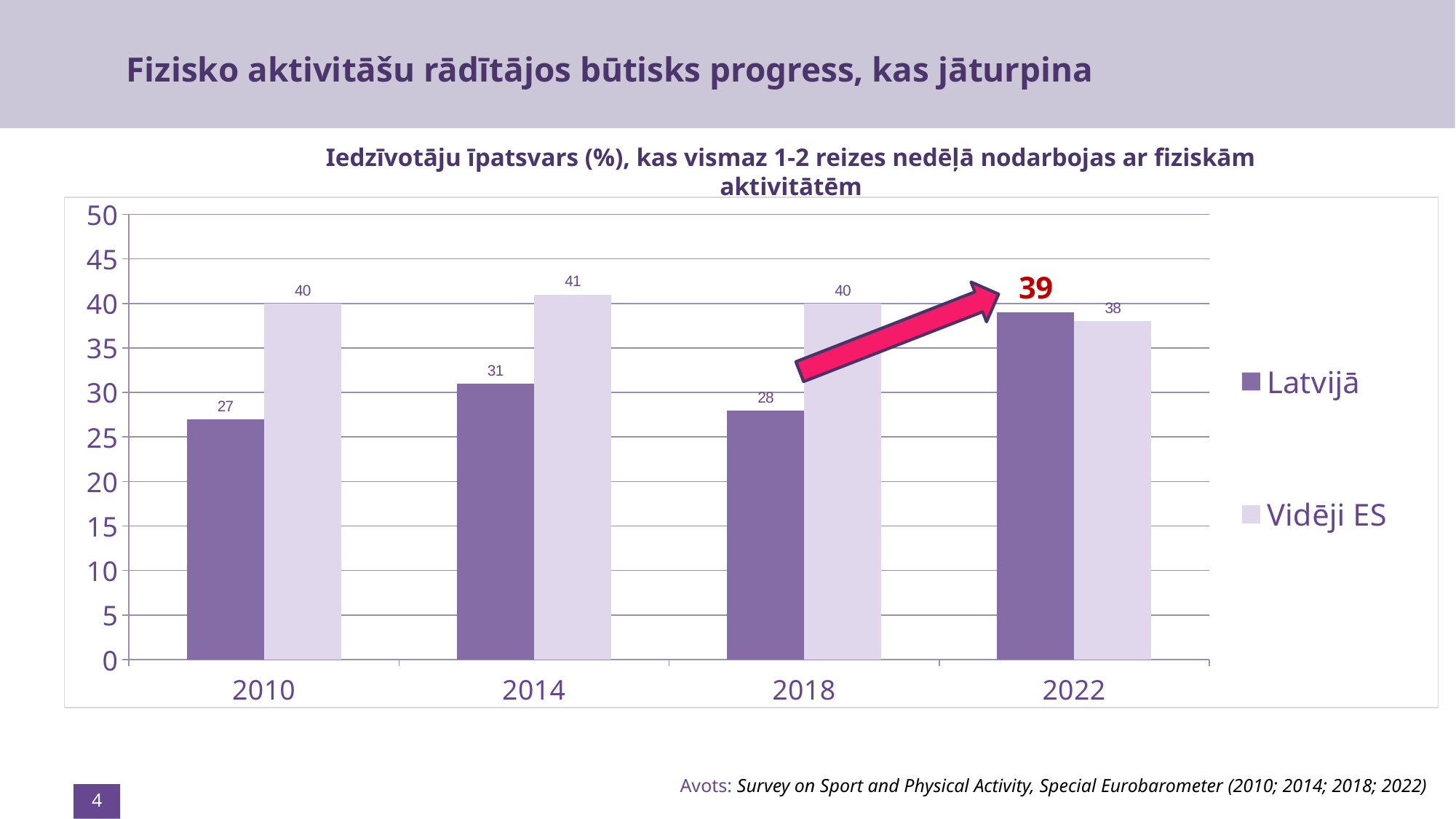
What is the value for Latvijā in 2022? 39 In which year is the Latvijā value lowest? 2010 What kind of chart is shown on the slide? bar chart In which year is the Latvijā value highest? 2022 What is the value for Latvijā in 2010? 27 Is the value for Latvijā in 2018 greater or less than 30? less Which is larger in 2022, Latvijā or Vidēji ES? Latvijā What is the difference between the Vidēji ES and Latvijā values in 2010? 13 How many years are shown on the x axis? 4 Which series is shown in the darker purple colour? Latvijā What is the value for Vidēji ES in 2014? 41 How many series does the legend list? 2